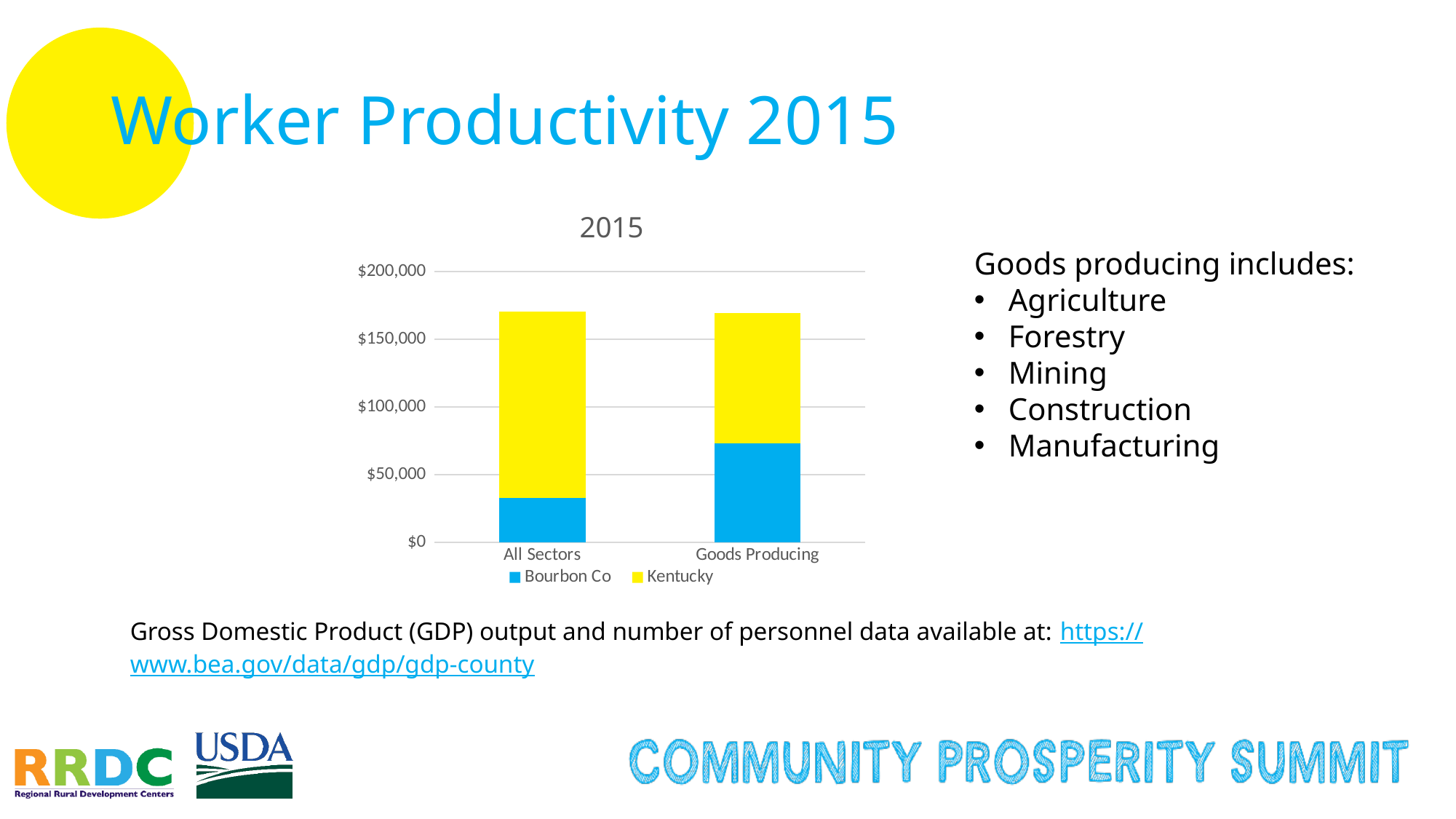
Is the Bourbon Co value for Goods Producing greater or less than $100,000? less For Bourbon Co, which category has the higher value: All Sectors or Goods Producing? Goods Producing Is the total stacked value for All Sectors greater or less than $150,000? greater Is the Bourbon Co value for Goods Producing greater or less than $50,000? greater What kind of chart is shown on the slide? Stacked bar chart What is the title of the chart? 2015 Which colour represents Kentucky in the chart? Yellow How many series does the chart legend list? 2 For Kentucky, which category has the larger segment: All Sectors or Goods Producing? All Sectors How many categories are shown on the x axis of the chart? 2